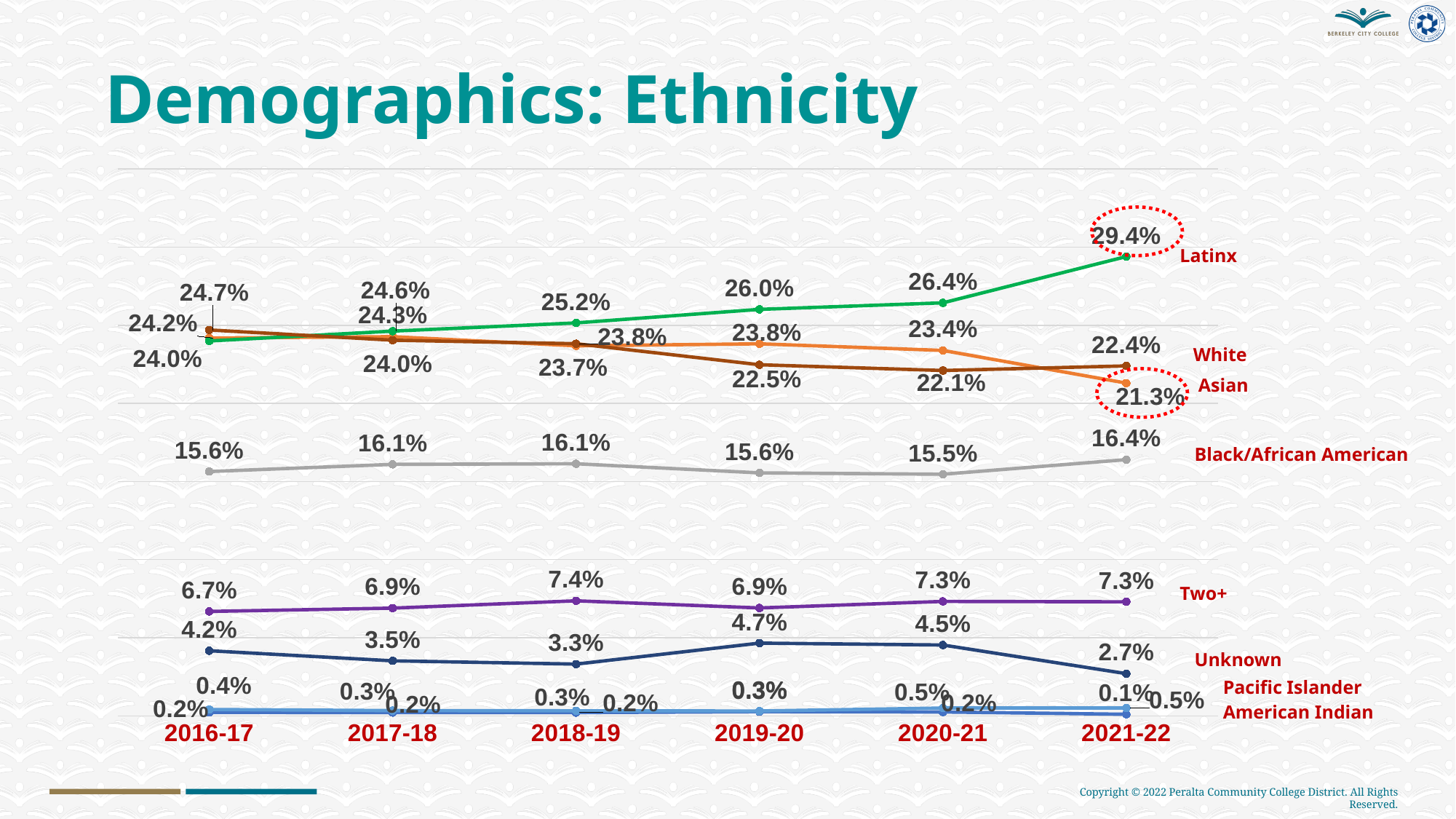
By how many percentage points did the Latinx share change from 2020-21 to 2021-22? 3.0 percentage points In which year is the Two+ value highest? 2018-19 What is the Black/African American value for 2021-22? 16.4% Does the Latinx line rise or fall from 2016-17 to 2021-22? Rises In 2021-22, which is larger, the White value or the Asian value? White What is the Unknown value for 2021-22? 2.7% How many academic years are shown on the x axis? 6 What percentage is shown for Asian in 2021-22? 21.3% Which ethnicity group has the highest value in 2021-22? Latinx In which year is the Unknown value lowest? 2021-22 What percentage is shown for Latinx in 2021-22? 29.4% What is the difference between the White and Asian values in 2021-22? 1.1 percentage points